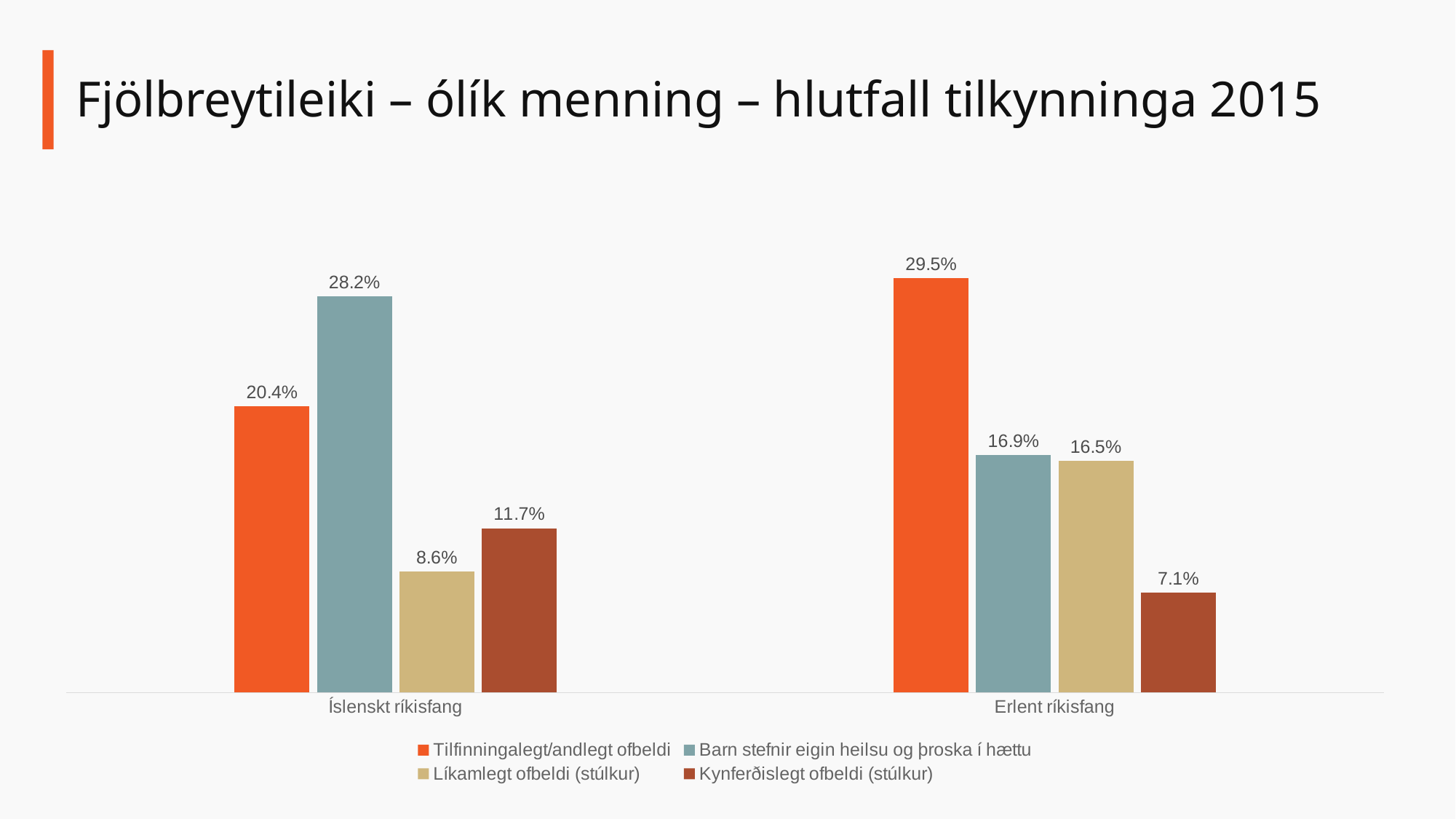
What is the title of the slide? Fjölbreytileiki – ólík menning – hlutfall tilkynninga 2015 Which series has the lowest value in the Íslenskt ríkisfang category? Líkamlegt ofbeldi (stúlkur) What is the difference between the Tilfinningalegt/andlegt ofbeldi values for Erlent ríkisfang and Íslenskt ríkisfang? 9.1% What is the value for Kynferðislegt ofbeldi (stúlkur) in the Íslenskt ríkisfang category? 11.7% Which is larger: Barn stefnir eigin heilsu og þroska í hættu for Íslenskt ríkisfang or for Erlent ríkisfang? Íslenskt ríkisfang What is the value for Tilfinningalegt/andlegt ofbeldi in the Íslenskt ríkisfang category? 20.4% How many categories are shown on the x axis? 2 What is the value for Barn stefnir eigin heilsu og þroska í hættu in the Erlent ríkisfang category? 16.9% What kind of chart is shown on the slide? Bar chart How many series does the legend list? 4 What is the value for Líkamlegt ofbeldi (stúlkur) in the Erlent ríkisfang category? 16.5% Which series has the highest value in the Erlent ríkisfang category? Tilfinningalegt/andlegt ofbeldi